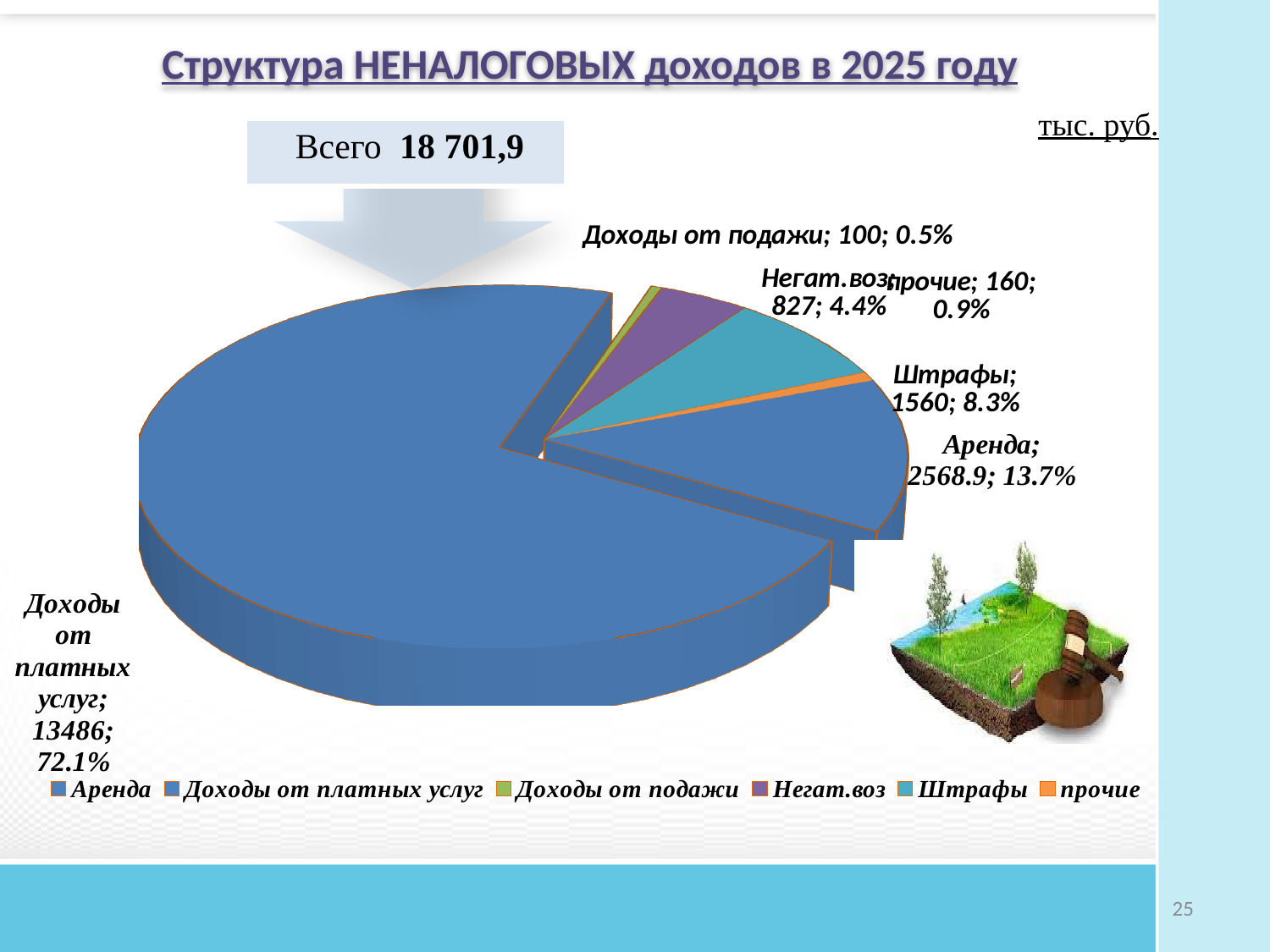
What percentage share is shown for Негат.воз? 4.4% What type of chart is shown on the slide? Pie chart What share of the pie does Аренда represent? 13.7% What is the value for Штрафы? 1560 What is the value for Доходы от платных услуг? 13486 Which category has the largest share of the pie? Доходы от платных услуг What is the value for прочие? 160 What is the difference between the values for Аренда and Штрафы? 1008.9 What total value (Всего) is shown above the chart? 18 701,9 Which category has the smallest share of the pie? Доходы от подажи How many categories does the legend list? 6 Which is larger, the value for Негат.воз or the value for прочие? Негат.воз